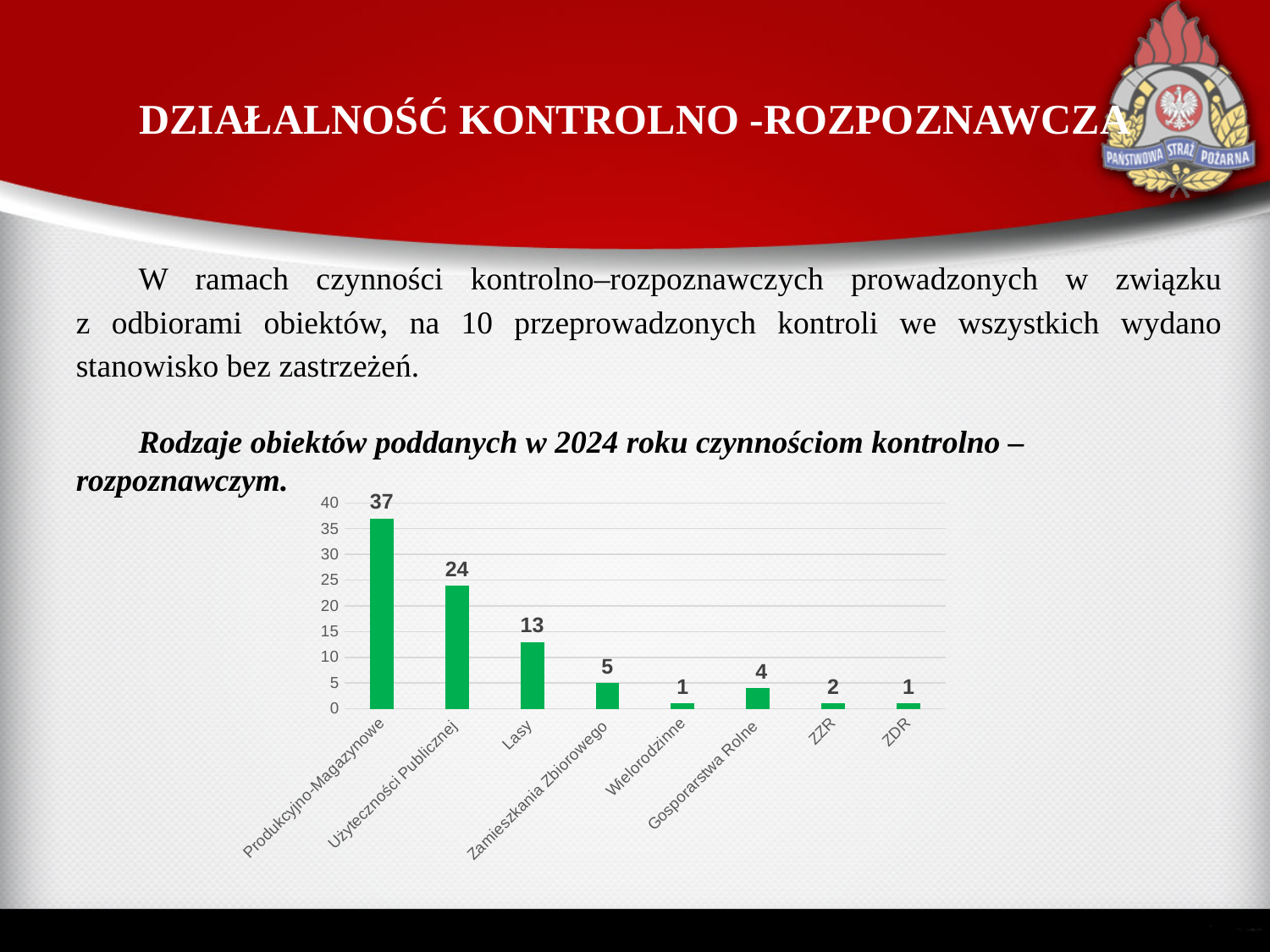
What is the value for Produkcyjno-Magazynowe? 37 Is the value for Lasy greater or less than 10? greater Which category has the highest value? Produkcyjno-Magazynowe What is the difference between the values for Produkcyjno-Magazynowe and Użyteczności Publicznej? 13 What is the value for Lasy? 13 What kind of chart is shown on the slide? bar chart How many categories are shown on the x axis? 8 What is the value for Gospodarstwa Rolne? 4 Which is larger, the value for Zamieszkania Zbiorowego or the value for Gospodarstwa Rolne? Zamieszkania Zbiorowego What is the value for Użyteczności Publicznej? 24 What is the value for ZZR? 2 What colour are the bars in the chart? green